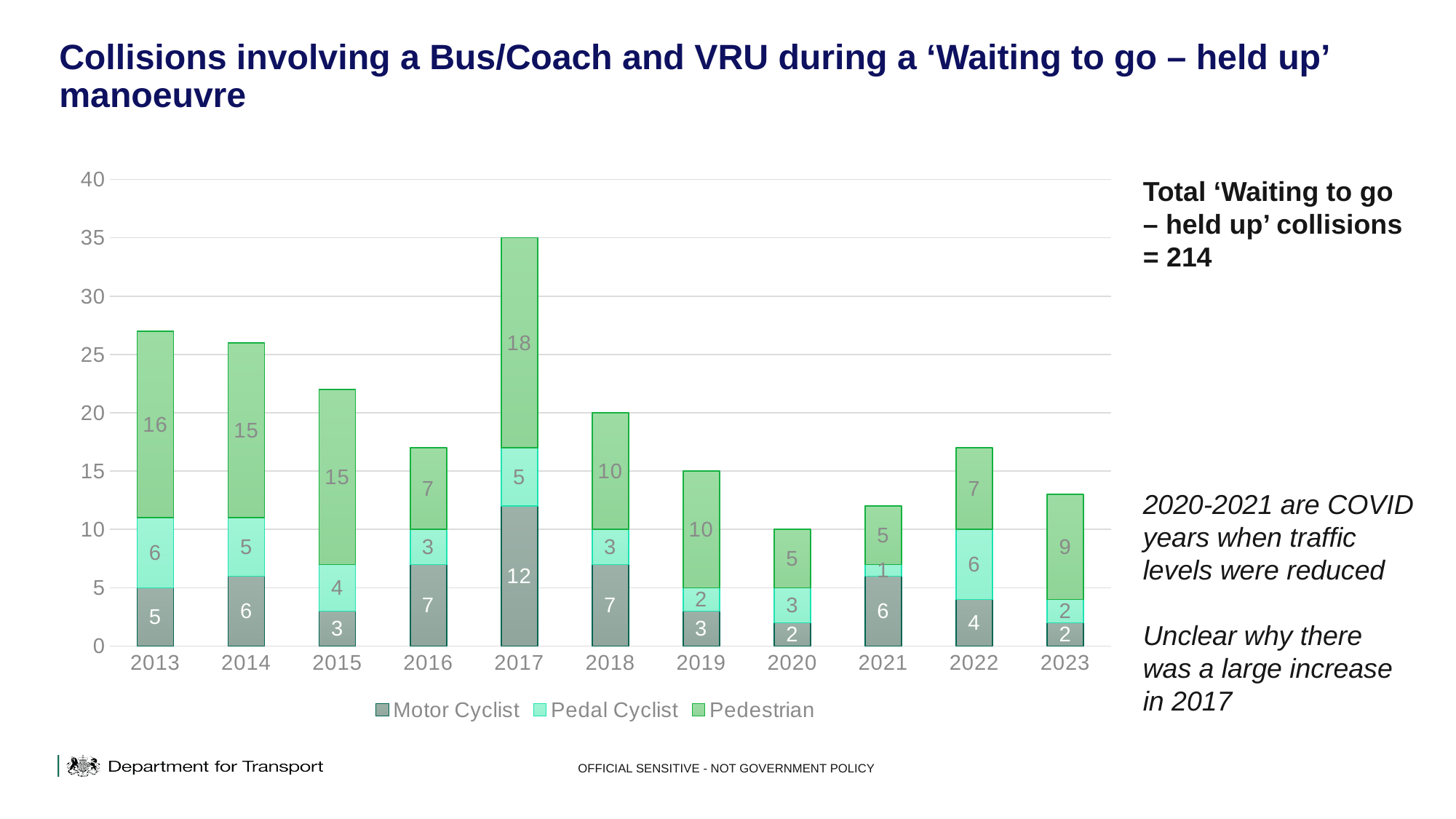
What is the Pedestrian value for 2017? 18 What is the total of the stacked bar for 2013? 27 How many years are shown on the x axis? 11 What is the Pedal Cyclist value for 2022? 6 What is the difference between the Pedestrian values for 2017 and 2018? 8 What is the total of the stacked bar for 2020? 10 What is the Motor Cyclist value for 2021? 6 What kind of chart is shown on the slide? Stacked bar chart Which year has the lowest Pedal Cyclist value? 2021 How many series does the legend list? 3 Which is larger, the Pedestrian value for 2013 or for 2014? 2013 Which year has the highest Motor Cyclist value? 2017